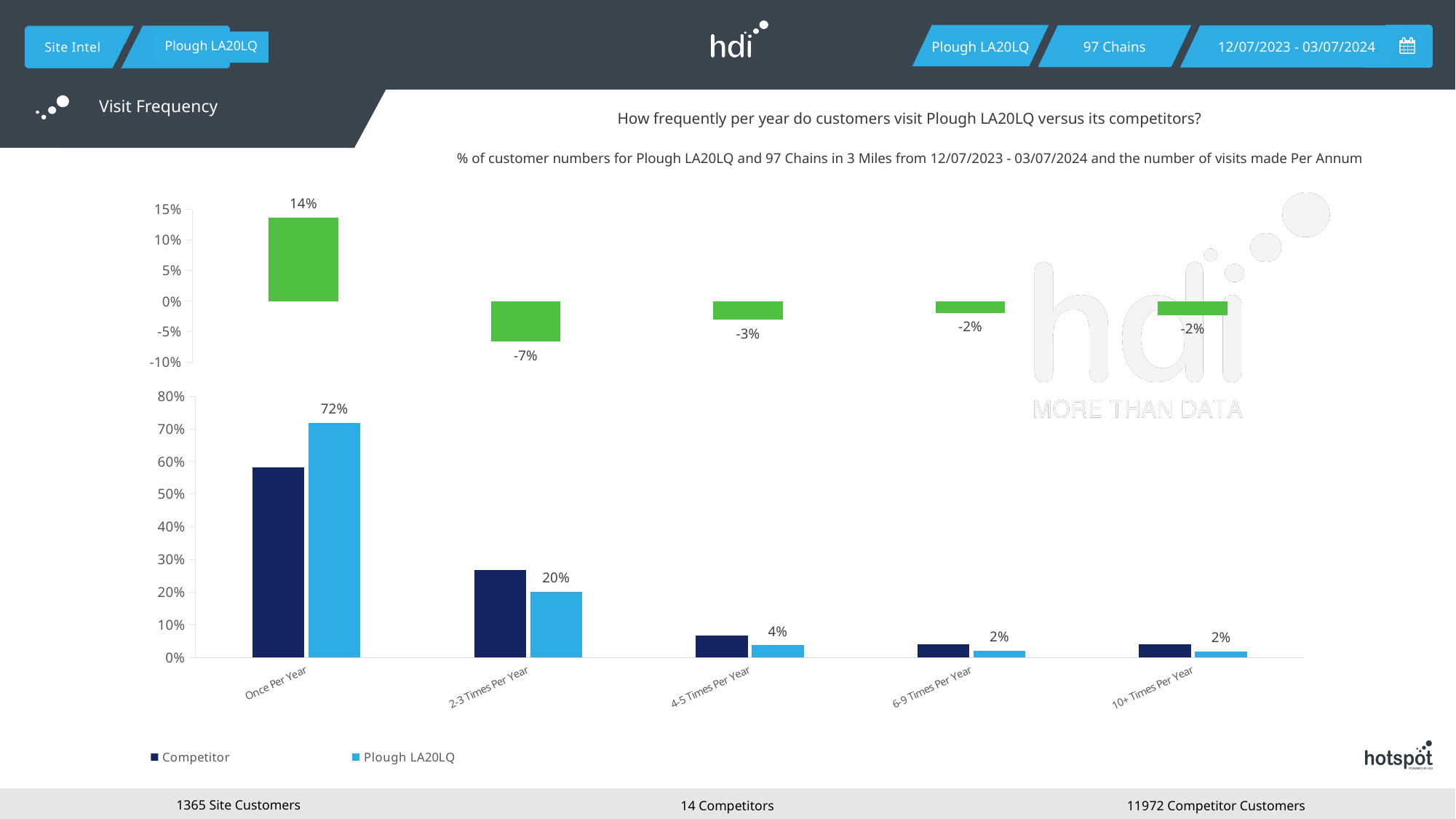
In the top chart, what is the value shown for Once Per Year? 14% In the bottom chart, is the Competitor value for Once Per Year greater or less than 50%? greater In the bottom chart, for Once Per Year, which series has the larger value: Competitor or Plough LA20LQ? Plough LA20LQ How many series does the legend of the bottom chart list? 2 In the bottom chart, what is the value for Plough LA20LQ in the 2-3 Times Per Year category? 20% In the bottom chart, what is the value for Plough LA20LQ in the Once Per Year category? 72% In the top chart, which category has the lowest value? 2-3 Times Per Year In the top chart, which category has the highest value? Once Per Year In the bottom chart, what is the difference between the Plough LA20LQ values for Once Per Year and 2-3 Times Per Year? 52% In the bottom chart, is the Competitor value for 2-3 Times Per Year greater or less than 30%? less In the top chart, what is the value shown for 2-3 Times Per Year? -7% In the bottom chart, for 2-3 Times Per Year, which series has the larger value: Competitor or Plough LA20LQ? Competitor